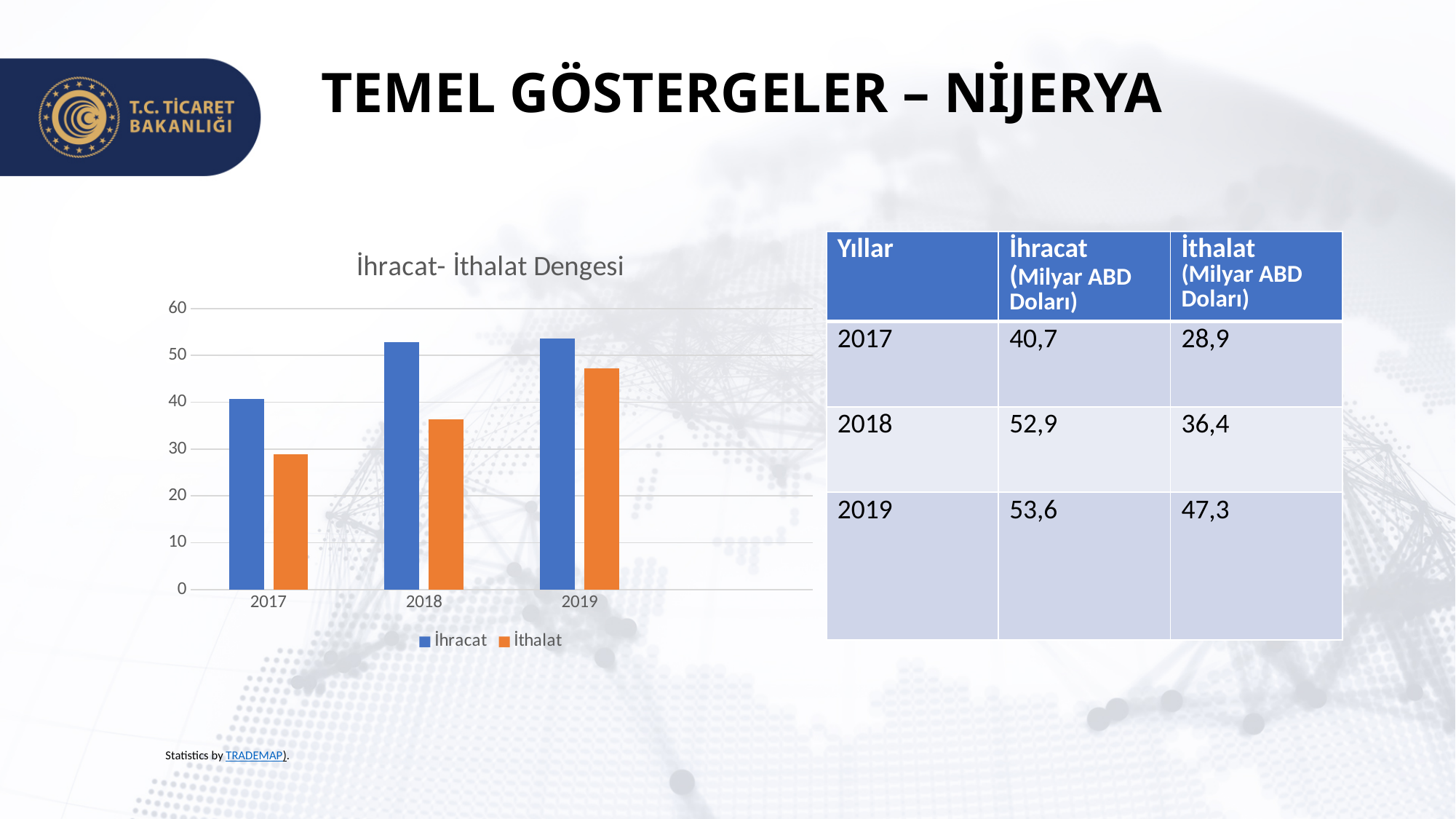
How many series does the legend of the 'İhracat- İthalat Dengesi' chart list? 2 Do the İthalat values rise or fall from 2017 to 2019? rise What is the İhracat value for 2018 (Milyar ABD Doları)? 52,9 What is the İthalat value for 2017 (Milyar ABD Doları)? 28,9 What type of chart is shown under the title 'İhracat- İthalat Dengesi'? bar chart What is the İthalat value for 2019 (Milyar ABD Doları)? 47,3 In which year is the İhracat value lowest? 2017 In which year is the İthalat value highest? 2019 What is the difference between İhracat and İthalat in 2017 (Milyar ABD Doları)? 11,8 In 2018, which is larger, İhracat or İthalat? İhracat Is the İthalat value for 2017 greater or less than 30? less How many years are shown on the x axis of the 'İhracat- İthalat Dengesi' chart? 3